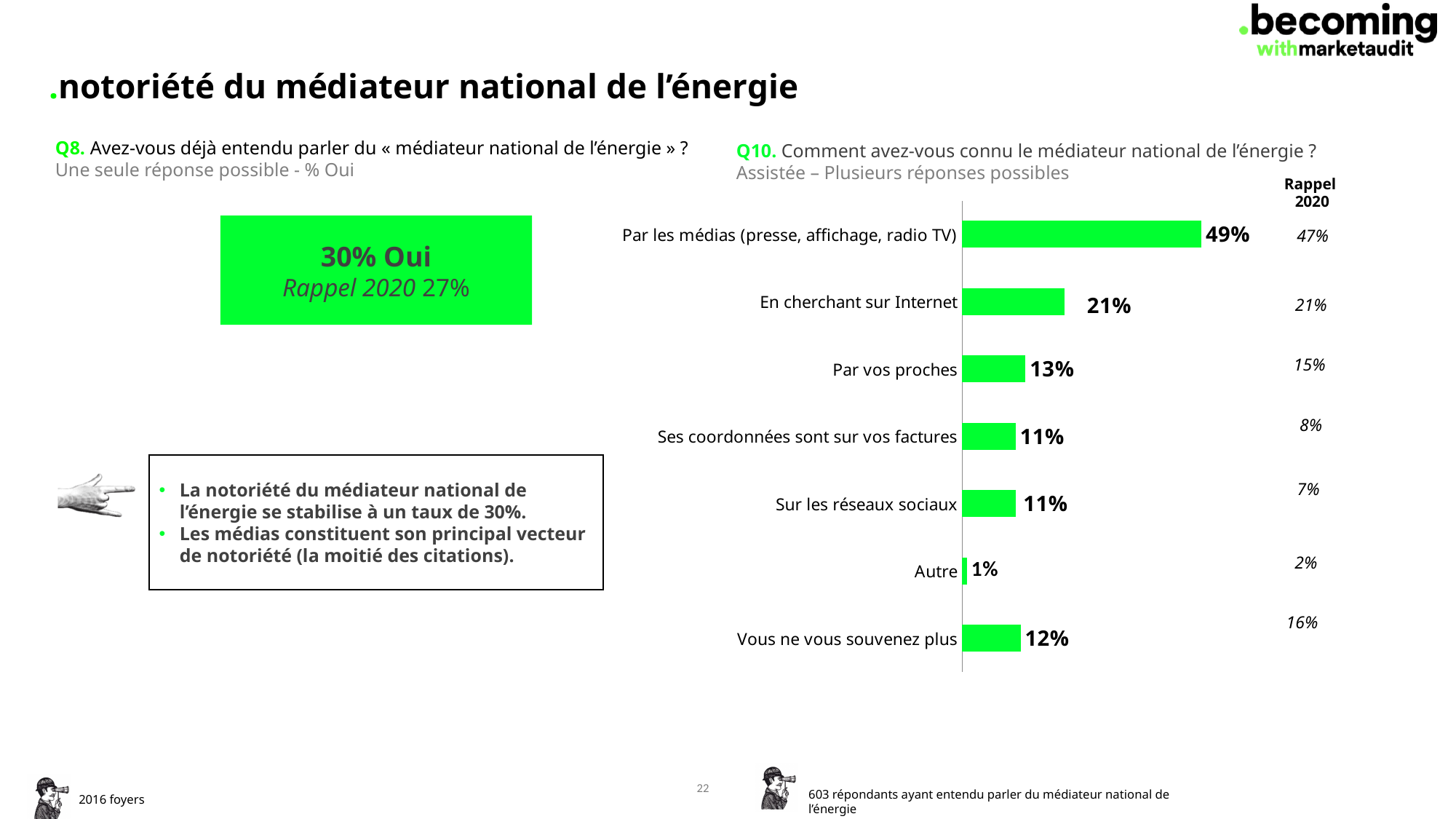
In the Q10 chart, which is larger: 'En cherchant sur Internet' or 'Par vos proches'? En cherchant sur Internet In the Q10 chart, what is the value for 'Vous ne vous souvenez plus'? 12% In the Q10 chart, what percentage of respondents knew the médiateur national de l'énergie through the media (Par les médias)? 49% In the Q10 chart, which category has the highest value? Par les médias (presse, affichage, radio TV) In the Q10 chart, what is the difference between 'Par les médias' and 'En cherchant sur Internet'? 28 percentage points What type of chart is used for Q10? Bar chart What colour are the bars in the Q10 chart? Green In the Q10 chart, which category has the lowest value? Autre In the Q10 chart, what was the 'Rappel 2020' value for 'Par les médias'? 47% How many categories are shown in the Q10 chart? 7 In the Q10 chart, what is the value for 'Par vos proches'? 13% In the Q10 chart, what is the value for 'En cherchant sur Internet'? 21%